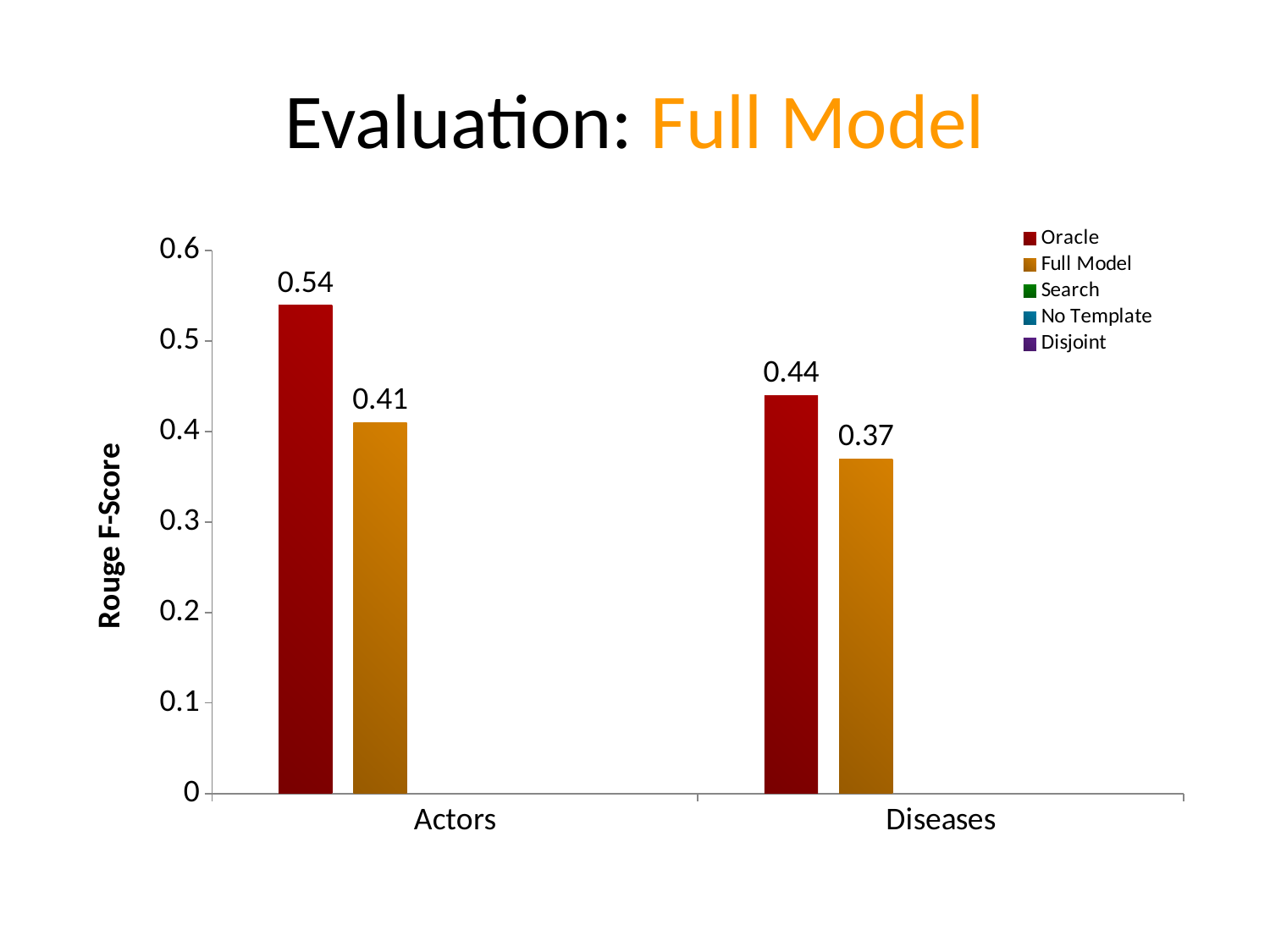
Which bar has the lowest value on the chart? Full Model on Diseases What is the difference between the Oracle and Full Model scores for Actors? 0.13 What is the difference between the Oracle and Full Model scores for Diseases? 0.07 How many series does the legend list? 5 How many categories are shown on the x axis? 2 What is the Rouge F-Score for Oracle on Actors? 0.54 What is the Rouge F-Score for Full Model on Diseases? 0.37 What is the Rouge F-Score for Full Model on Actors? 0.41 Which is larger, the Full Model score for Actors or the Full Model score for Diseases? Actors What kind of chart is shown on the slide? Bar chart What is the Rouge F-Score for Oracle on Diseases? 0.44 Which bar has the highest value on the chart? Oracle on Actors